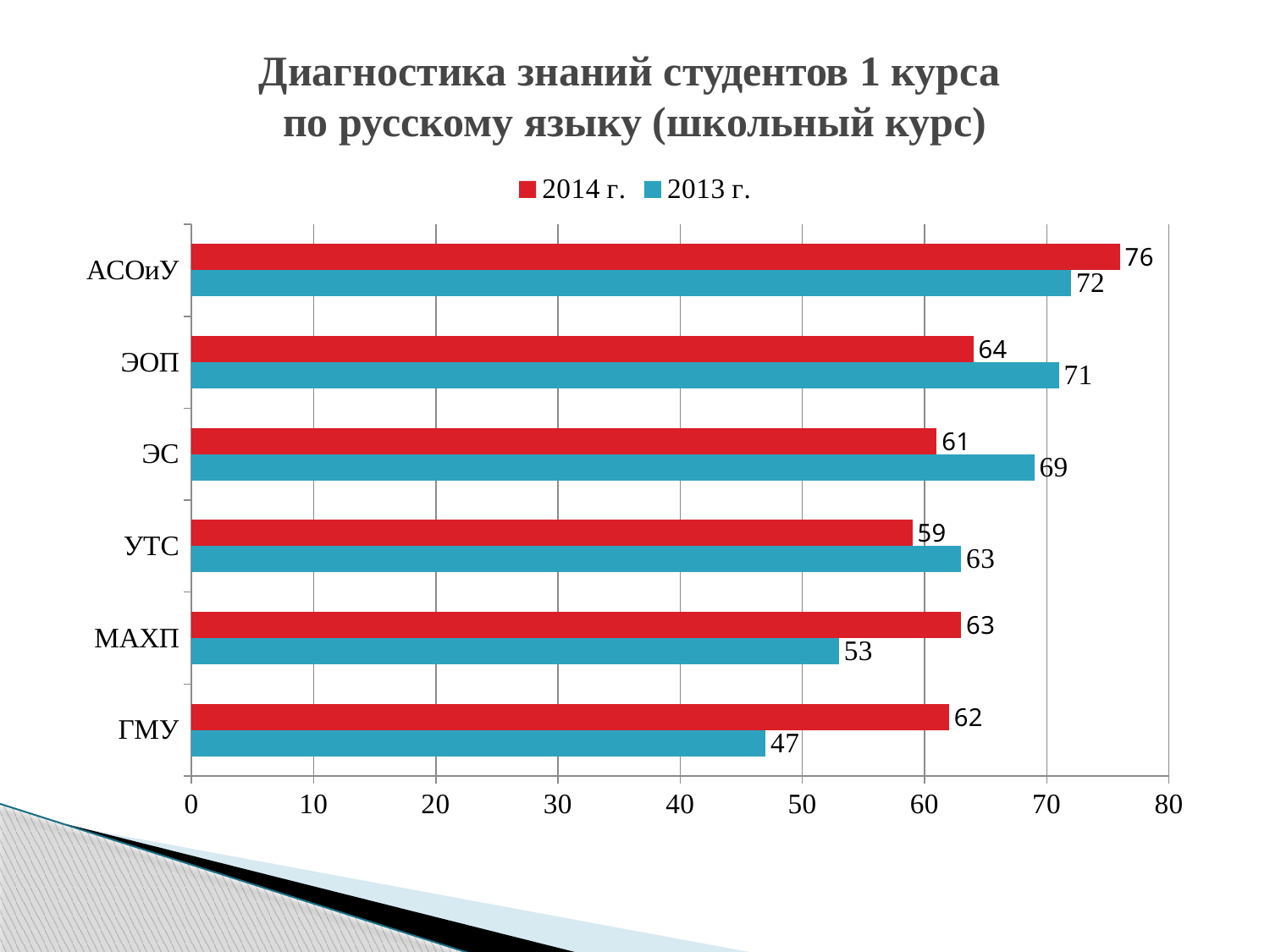
What is the 2014 г. value for АСОиУ? 76 Which colour represents the 2013 г. series? Blue Which is larger for ЭС: the 2014 г. value or the 2013 г. value? 2013 г. How many categories are shown on the chart? 6 How many series does the legend list? 2 Which is larger for МАХП: the 2014 г. value or the 2013 г. value? 2014 г. Which category has the highest 2014 г. value? АСОиУ What is the difference between the 2013 г. and 2014 г. values for ГМУ? 15 What is the 2013 г. value for ГМУ? 47 What kind of chart is shown on the slide? Bar chart What is the 2013 г. value for ЭОП? 71 Which category has the lowest 2013 г. value? ГМУ